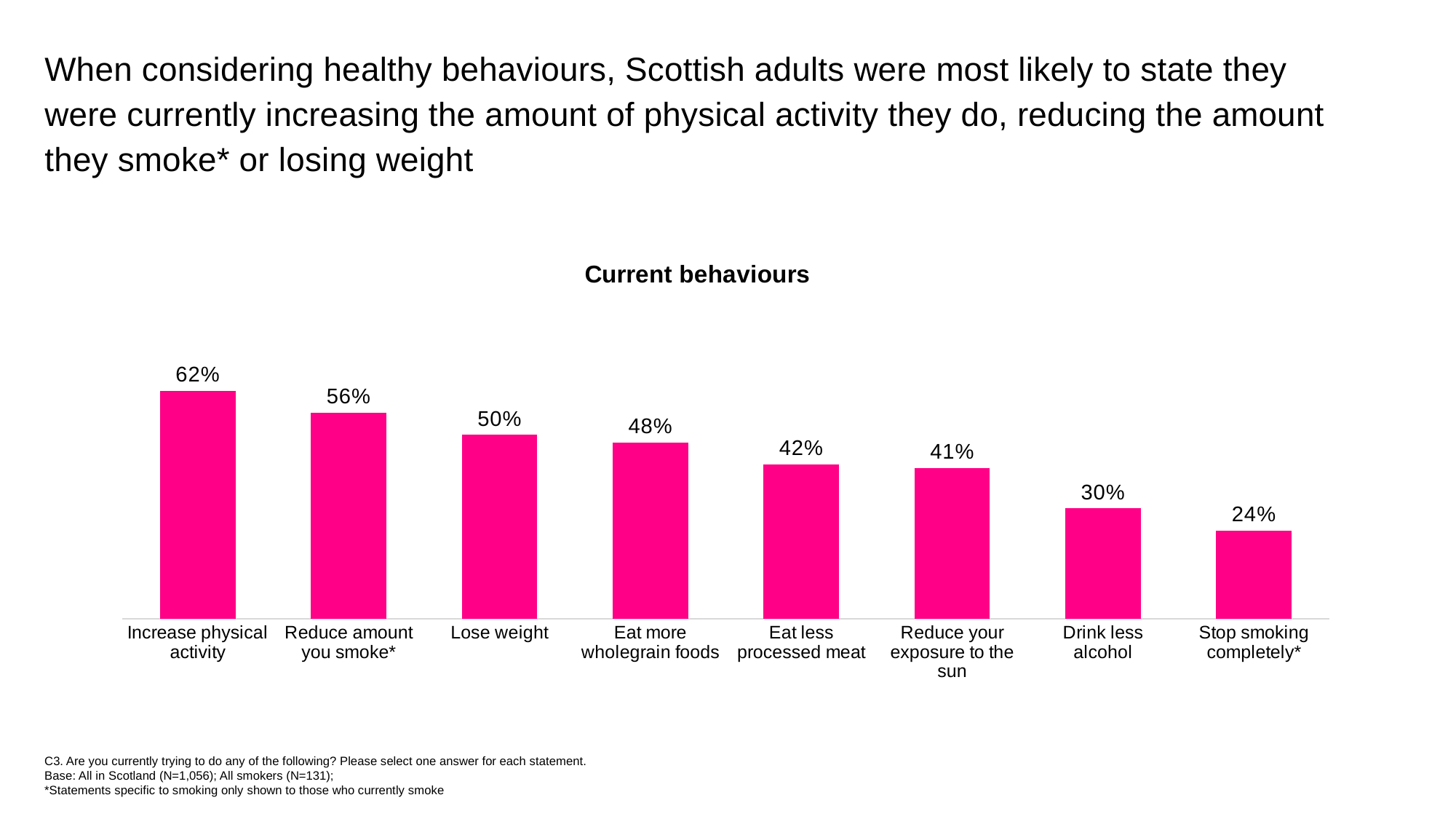
What is the difference between the values for 'Increase physical activity' and 'Stop smoking completely*'? 38 percentage points What type of chart is used on this slide? Bar chart What percentage is shown for 'Drink less alcohol'? 30% Do the values rise or fall moving from left to right across the chart? Fall Which behaviour has the highest value in the chart? Increase physical activity Which is larger: the value for 'Eat more wholegrain foods' or 'Drink less alcohol'? Eat more wholegrain foods Which behaviour has the lowest value in the chart? Stop smoking completely* What is the title of the chart? Current behaviours How many behaviours are shown in the chart? 8 What percentage of Scottish adults said they are currently trying to increase physical activity? 62% What is the difference between 'Reduce amount you smoke*' and 'Lose weight'? 6 percentage points What is the value shown for 'Lose weight'? 50%